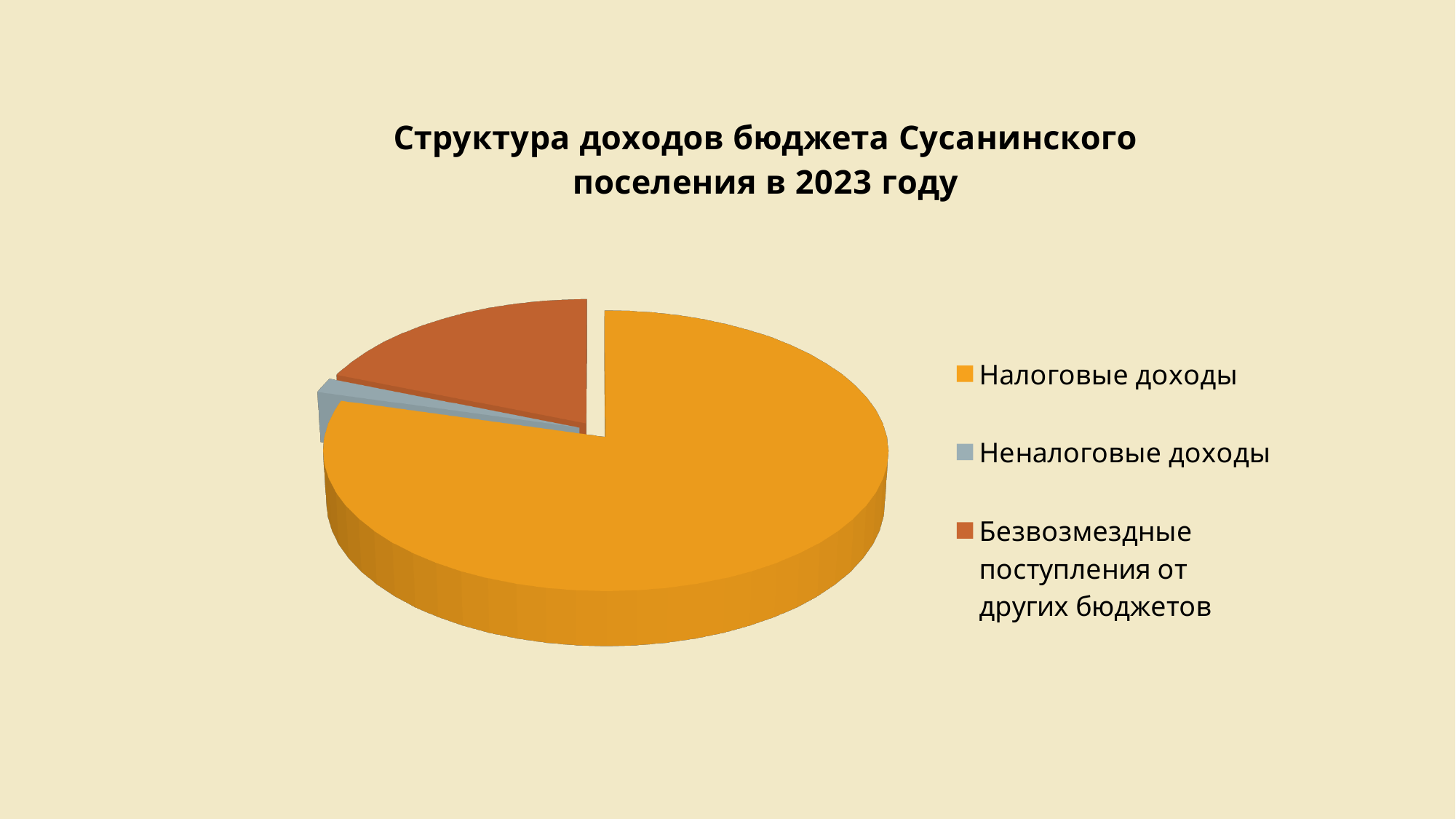
What kind of chart is shown on the slide? Pie chart Does the Налоговые доходы slice make up more or less than half of the pie? More Which category has the smallest slice of the pie? Неналоговые доходы Which slice is larger: Налоговые доходы or Безвозмездные поступления от других бюджетов? Налоговые доходы What is the title of the chart? Структура доходов бюджета Сусанинского поселения в 2023 году Which colour represents Неналоговые доходы in the legend? Grey How many categories (slices) does the pie chart have? 3 Which category has the largest slice of the pie? Налоговые доходы Which slice is larger: Безвозмездные поступления от других бюджетов or Неналоговые доходы? Безвозмездные поступления от других бюджетов